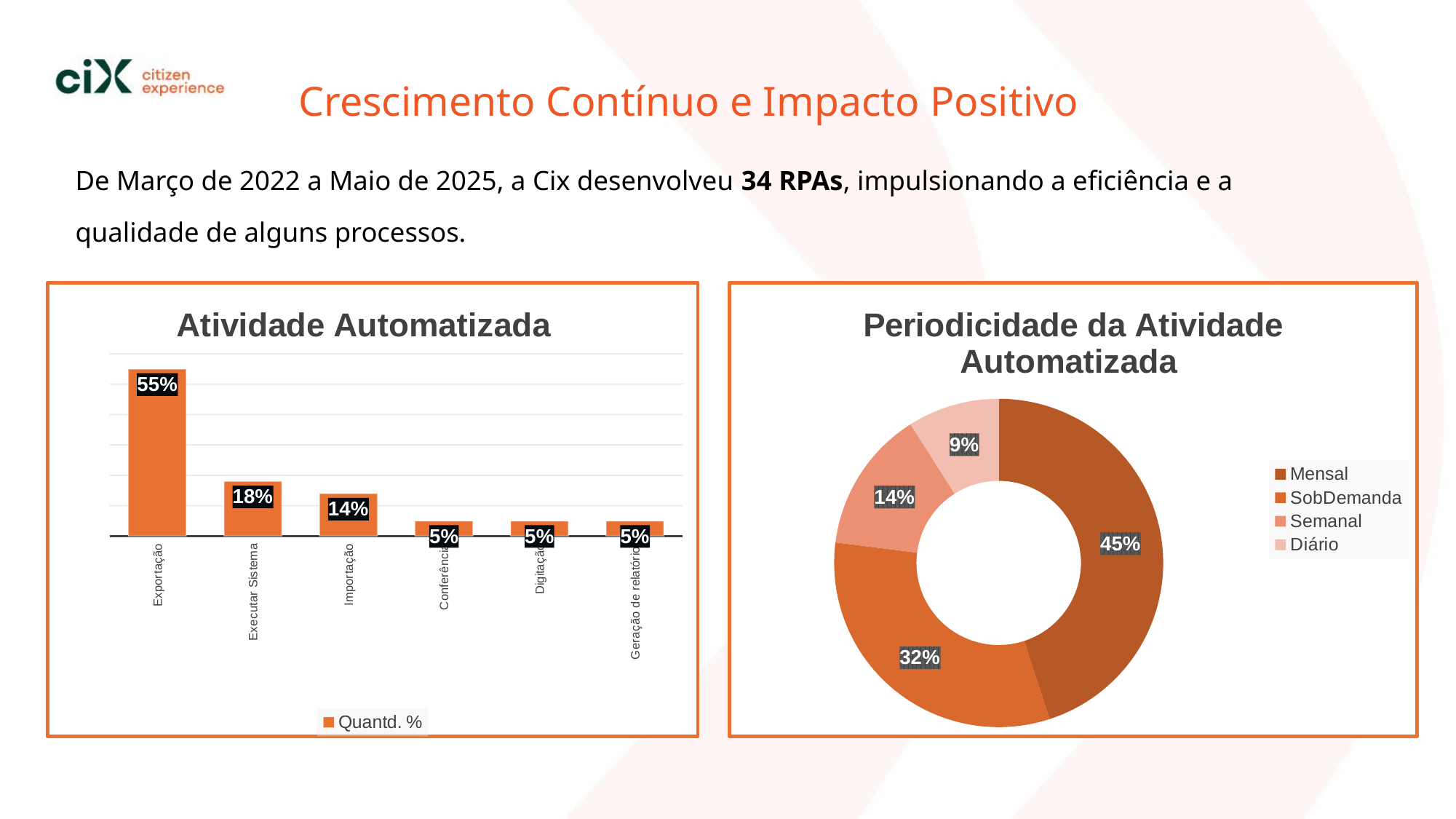
In the 'Atividade Automatizada' chart, what is the value for Executar Sistema? 18% In the 'Periodicidade da Atividade Automatizada' chart, what share does Mensal have? 45% In the 'Atividade Automatizada' chart, what is the name of the series shown in the legend? Quantd. % In the 'Atividade Automatizada' chart, how many categories are shown on the x axis? 6 What kind of chart is 'Atividade Automatizada'? Bar chart How many entries does the legend of the 'Periodicidade da Atividade Automatizada' chart list? 4 In the 'Atividade Automatizada' chart, what is the value for Exportação? 55% In the 'Atividade Automatizada' chart, which category has the highest value? Exportação In the 'Periodicidade da Atividade Automatizada' chart, what share does SobDemanda have? 32% In the 'Atividade Automatizada' chart, what is the difference between the values for Exportação and Importação? 41% In the 'Periodicidade da Atividade Automatizada' chart, which is larger, Semanal or Diário? Semanal In the 'Periodicidade da Atividade Automatizada' chart, which category has the smallest share? Diário